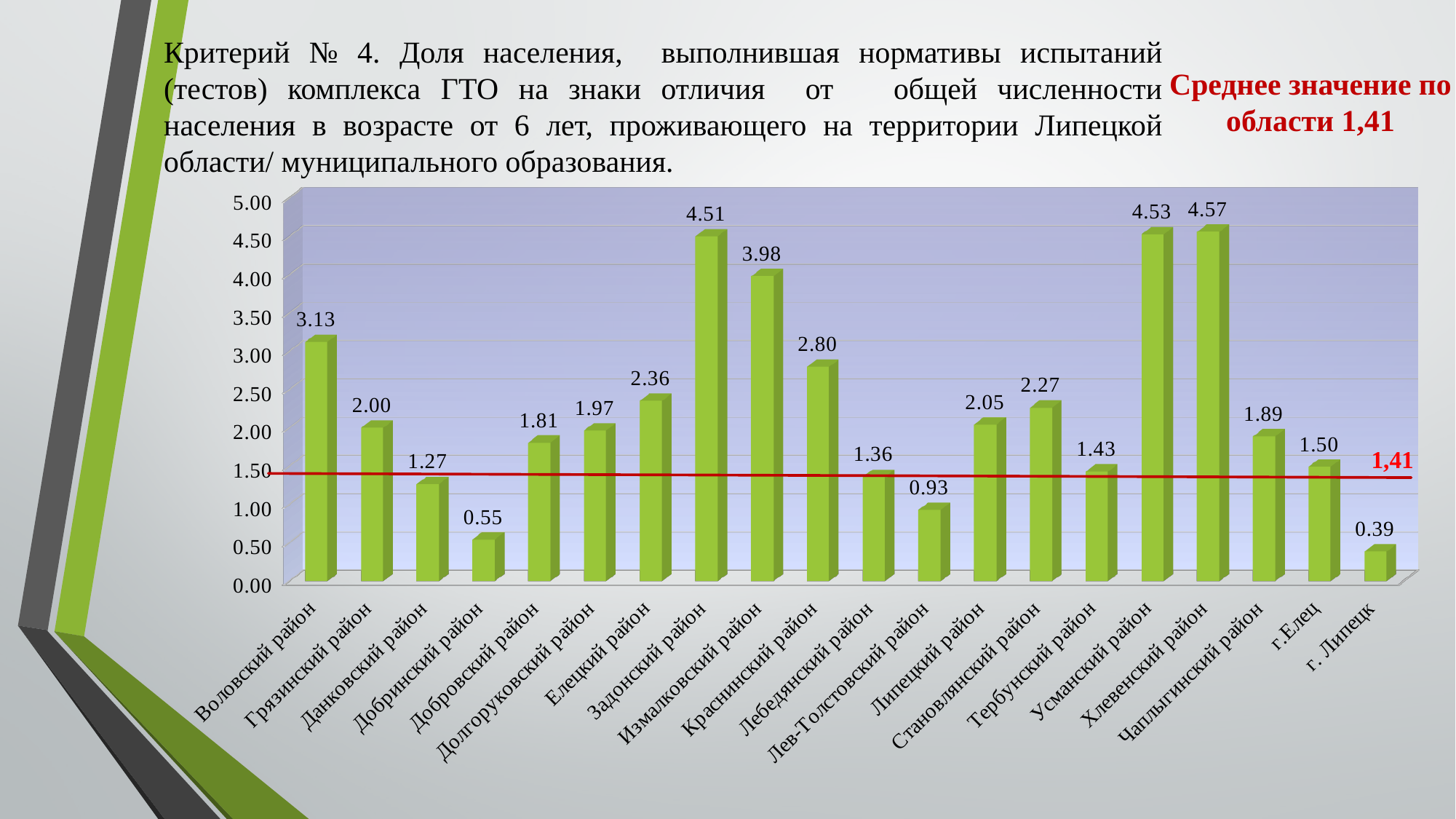
How many categories are shown on the x axis? 20 Which category has the lowest value? г. Липецк What is the value for г. Липецк? 0.39 What value does the red horizontal line mark? 1,41 What is the value for Задонский район? 4.51 What is the difference between the values for Воловский район and Грязинский район? 1.13 What is the value for Тербунский район? 1.43 Which is larger, the value for Измалковский район or the value for Краснинский район? Измалковский район What kind of chart is shown on the slide? bar chart Which category has the highest value? Хлевенский район What is the value for Лев-Толстовский район? 0.93 Is the value for Добринский район greater or less than 1.00? less